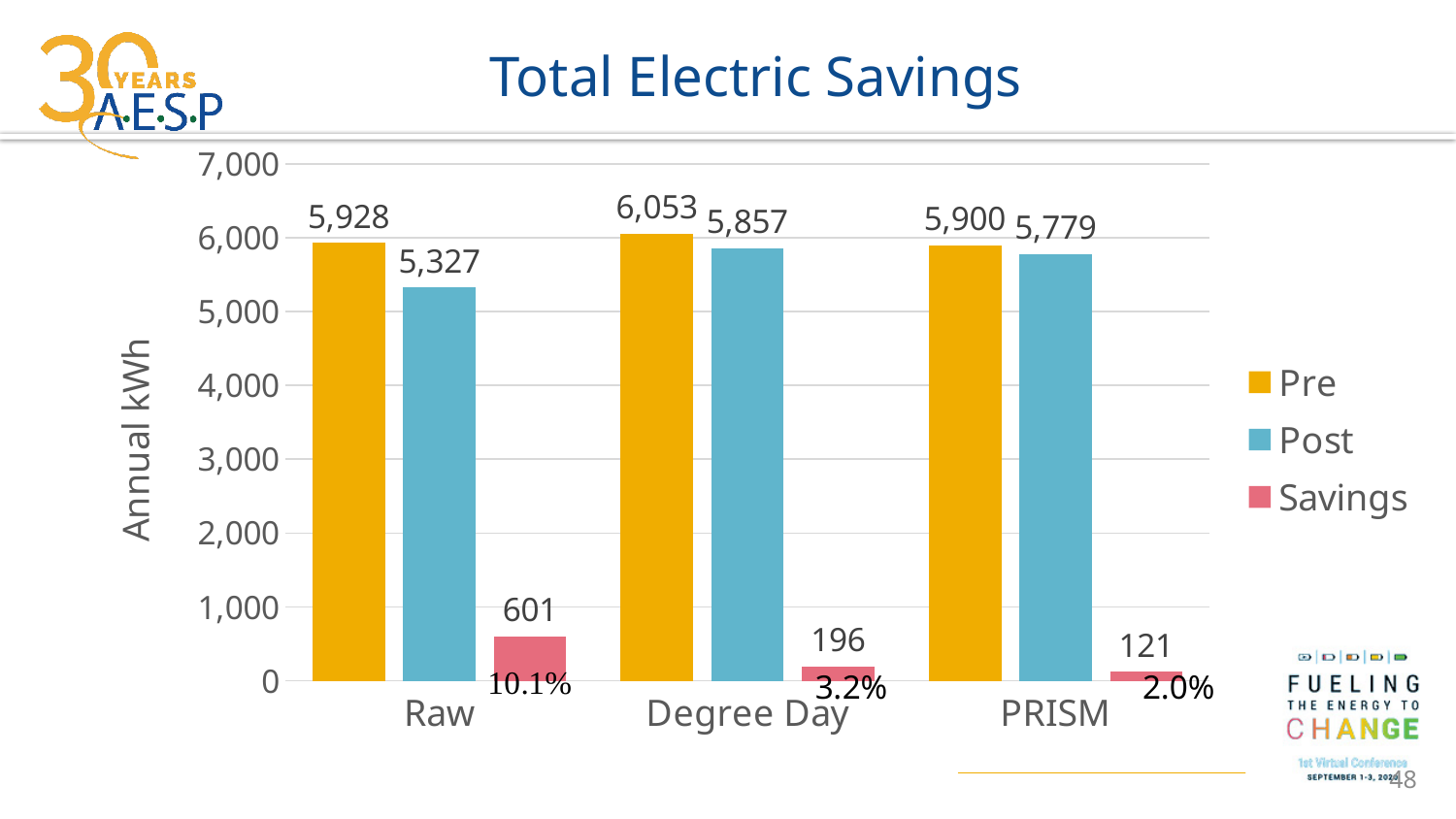
How many categories are shown on the x axis? 3 Which category has the lowest Pre value? PRISM What is the Pre value for Raw? 5,928 What is the Savings value for PRISM? 121 Is the Post value for Raw greater or less than 6,000? less What is the title of the chart? Total Electric Savings What kind of chart is shown on the slide? Bar chart How many series does the legend list? 3 What is the Post value for Degree Day? 5,857 What is the difference between the Pre and Post values for Raw? 601 Which category has the highest Savings value? Raw Is the Pre value for Degree Day larger than the Pre value for PRISM? Yes